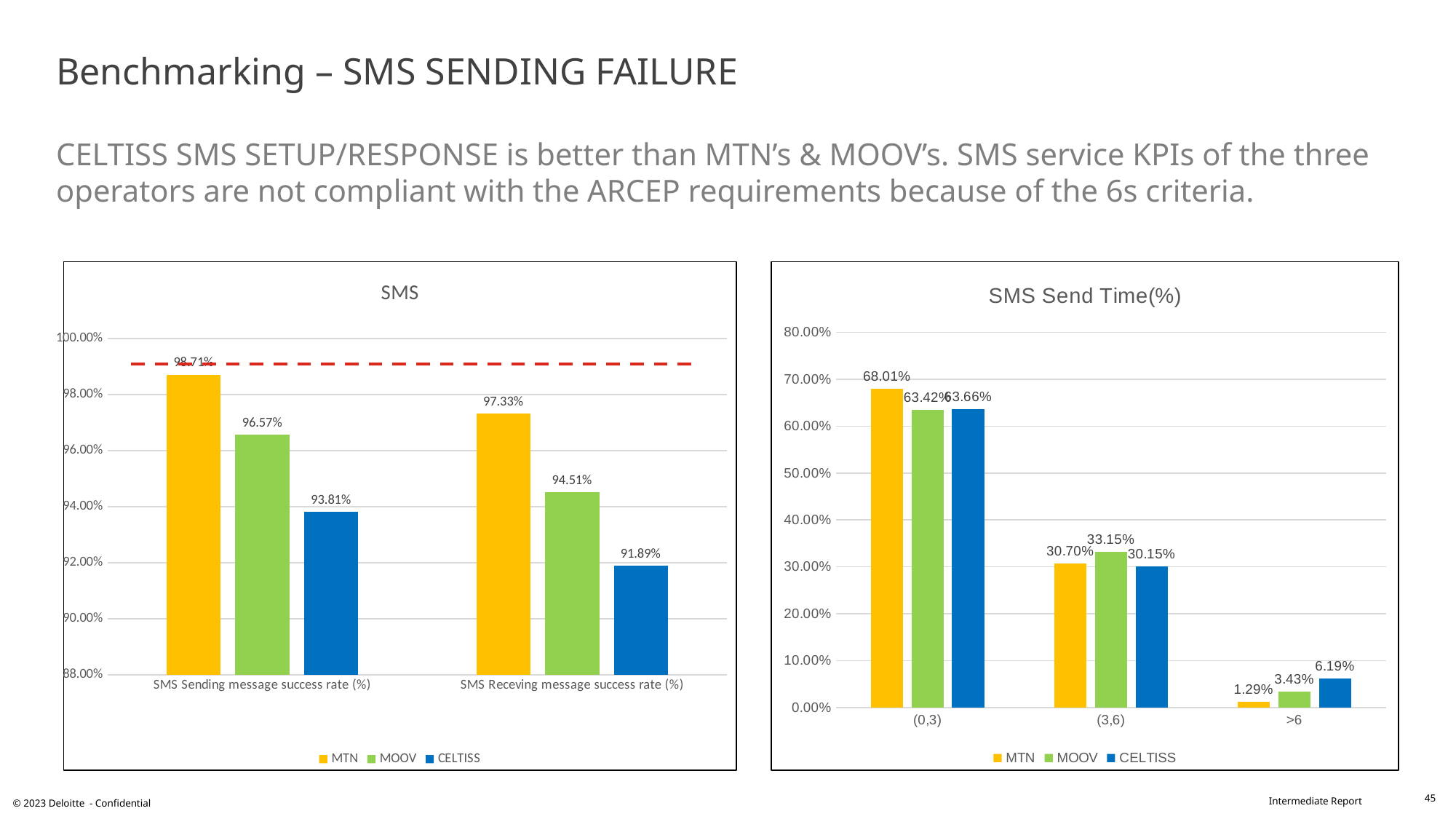
In the SMS chart on the left, what is the SMS Receving message success rate (%) for CELTISS? 91.89% In the SMS Send Time(%) chart on the right, what is the value for MTN in the (0,3) category? 68.01% In the SMS Send Time(%) chart on the right, which operator has the highest value in the (3,6) category? MOOV In the SMS chart on the left, what is the SMS Sending message success rate (%) for MTN? 98.71% In the SMS chart on the left, what is the difference between MTN's and MOOV's SMS Receving message success rate (%)? 2.82% In the SMS Send Time(%) chart on the right, is the value for MOOV in the (3,6) category greater or less than 30.00%? greater In the SMS Send Time(%) chart on the right, how many categories are shown on the x axis? 3 In the SMS chart on the left, which operator has the lowest SMS Sending message success rate (%)? CELTISS What kind of chart is the SMS Send Time(%) chart on the right? bar chart In the SMS Send Time(%) chart on the right, do the values for MTN rise or fall from (0,3) to >6? fall In the SMS Send Time(%) chart on the right, what is the value for CELTISS in the >6 category? 6.19% In the SMS chart on the left, how many series does the legend list? 3